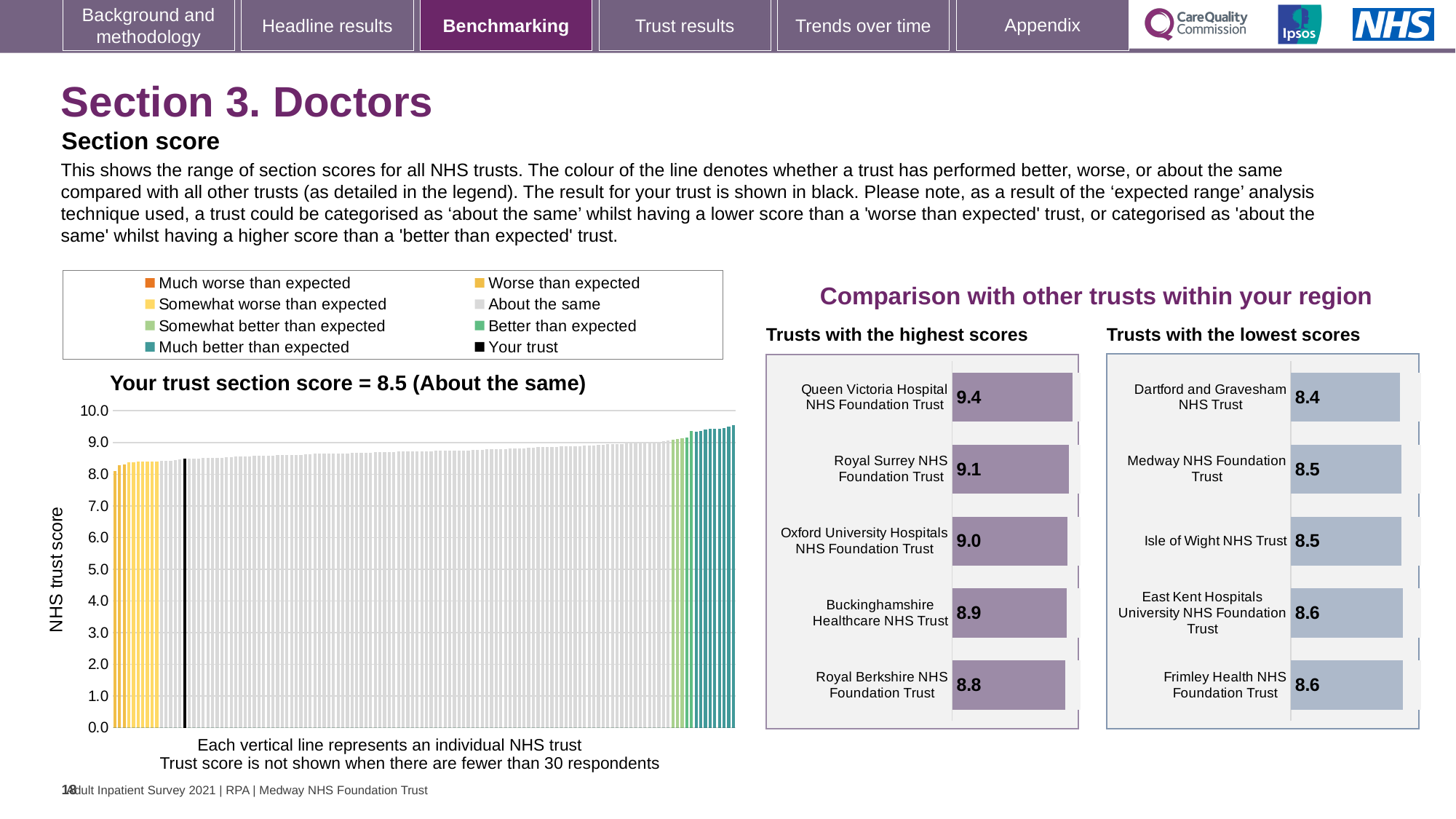
In the 'Trusts with the highest scores' chart, what is the score for Queen Victoria Hospital NHS Foundation Trust? 9.4 In the 'Trusts with the lowest scores' chart, what is the score for East Kent Hospitals University NHS Foundation Trust? 8.6 In the 'Trusts with the lowest scores' chart, which trust has the lowest score? Dartford and Gravesham NHS Trust In the 'Trusts with the highest scores' chart, which trust has the lowest score shown? Royal Berkshire NHS Foundation Trust How many trusts are listed in the 'Trusts with the lowest scores' chart? 5 How many entries does the legend of the main section score chart on the left list? 8 In the 'Trusts with the lowest scores' chart, what is the score for Dartford and Gravesham NHS Trust? 8.4 In the main section score chart on the left, what is your trust's section score as stated in the chart title? 8.5 In the main section score chart on the left, do the trust scores rise or fall from left to right along the x axis? rise In the 'Trusts with the highest scores' chart, what is the difference between the scores of Queen Victoria Hospital NHS Foundation Trust and Royal Berkshire NHS Foundation Trust? 0.6 In the 'Trusts with the highest scores' chart, which has the higher score: Royal Surrey NHS Foundation Trust or Oxford University Hospitals NHS Foundation Trust? Royal Surrey NHS Foundation Trust In the 'Trusts with the highest scores' chart, what is the score for Buckinghamshire Healthcare NHS Trust? 8.9